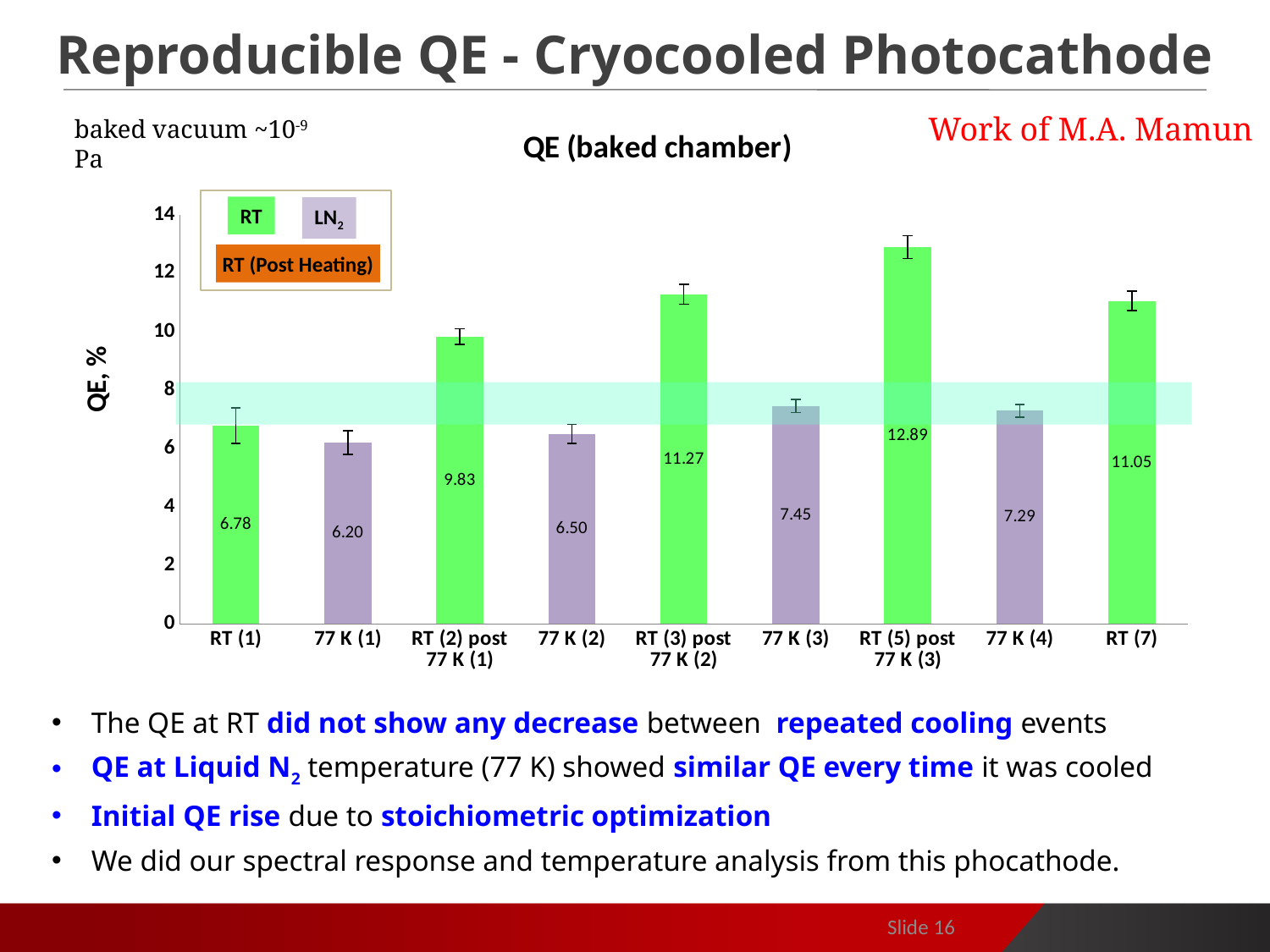
How many categories are shown on the x axis? 9 What is the title of the chart? QE (baked chamber) What is the difference between the QE for RT (3) post 77 K (2) and the QE for 77 K (2)? 4.77 What is the QE value for RT (1)? 6.78 Which category has the lowest QE? 77 K (1) Which is larger, the QE for 77 K (4) or the QE for 77 K (1)? 77 K (4) What kind of chart is shown on the slide? bar chart Is the QE value for RT (7) greater or less than 10? greater How many entries does the legend list? 3 What is the QE value for 77 K (3)? 7.45 What is the QE value for RT (5) post 77 K (3)? 12.89 Which category has the highest QE? RT (5) post 77 K (3)